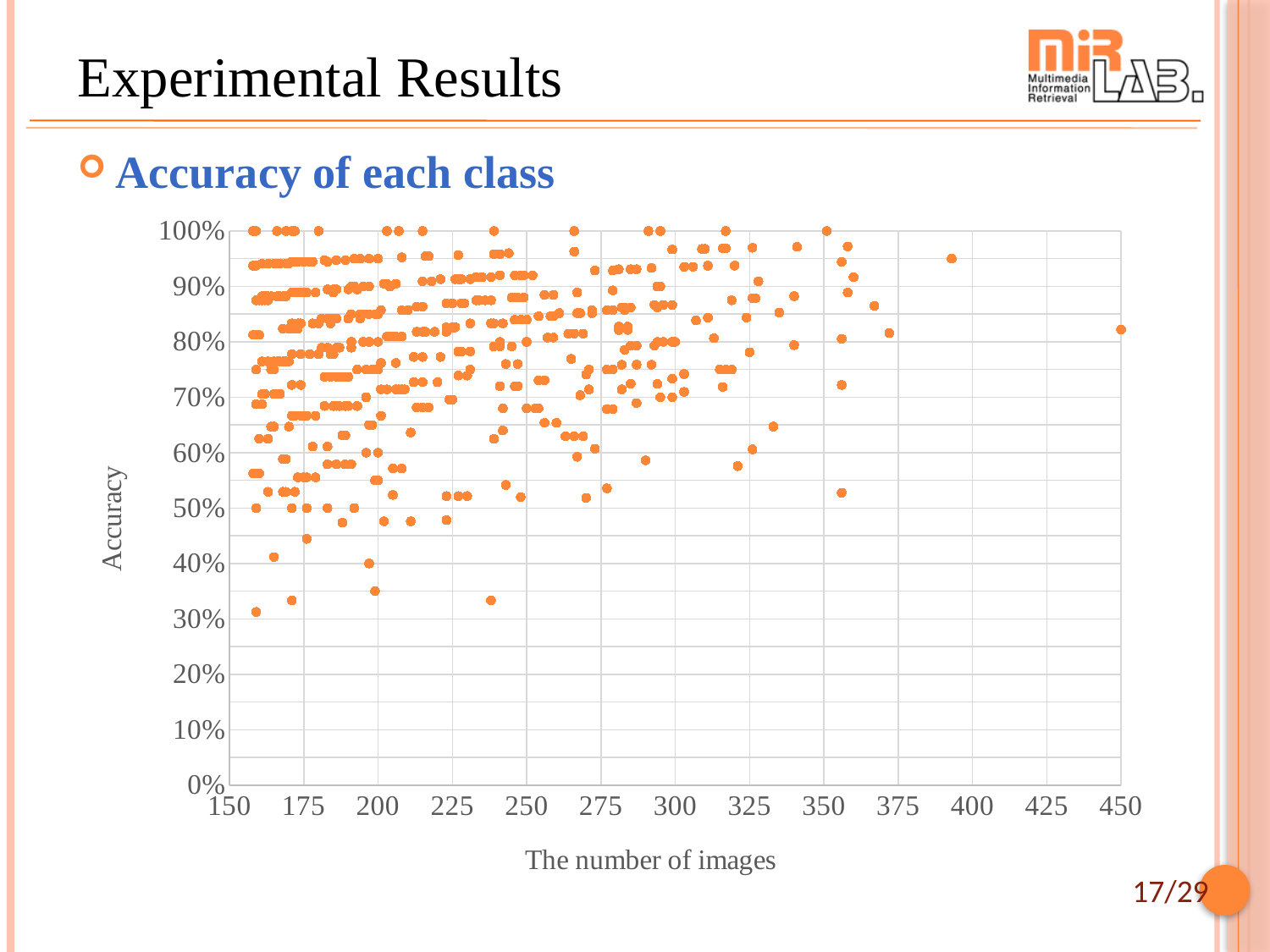
Is the lowest point plotted between 325 and 350 images greater or less than 70% accuracy? less What is the label of the y axis of the chart? Accuracy Is the lowest accuracy plotted on the chart greater or less than 40%? less Is the accuracy of the point plotted near 238 images at the bottom of the chart greater or less than 40%? less How many points are plotted at 450 images? 1 What is the highest accuracy value reached by any point on the chart? 100% What kind of chart is shown on the slide? scatter plot What is the label of the x axis of the chart? The number of images Do the lowest accuracies generally rise or fall as the number of images increases? rise